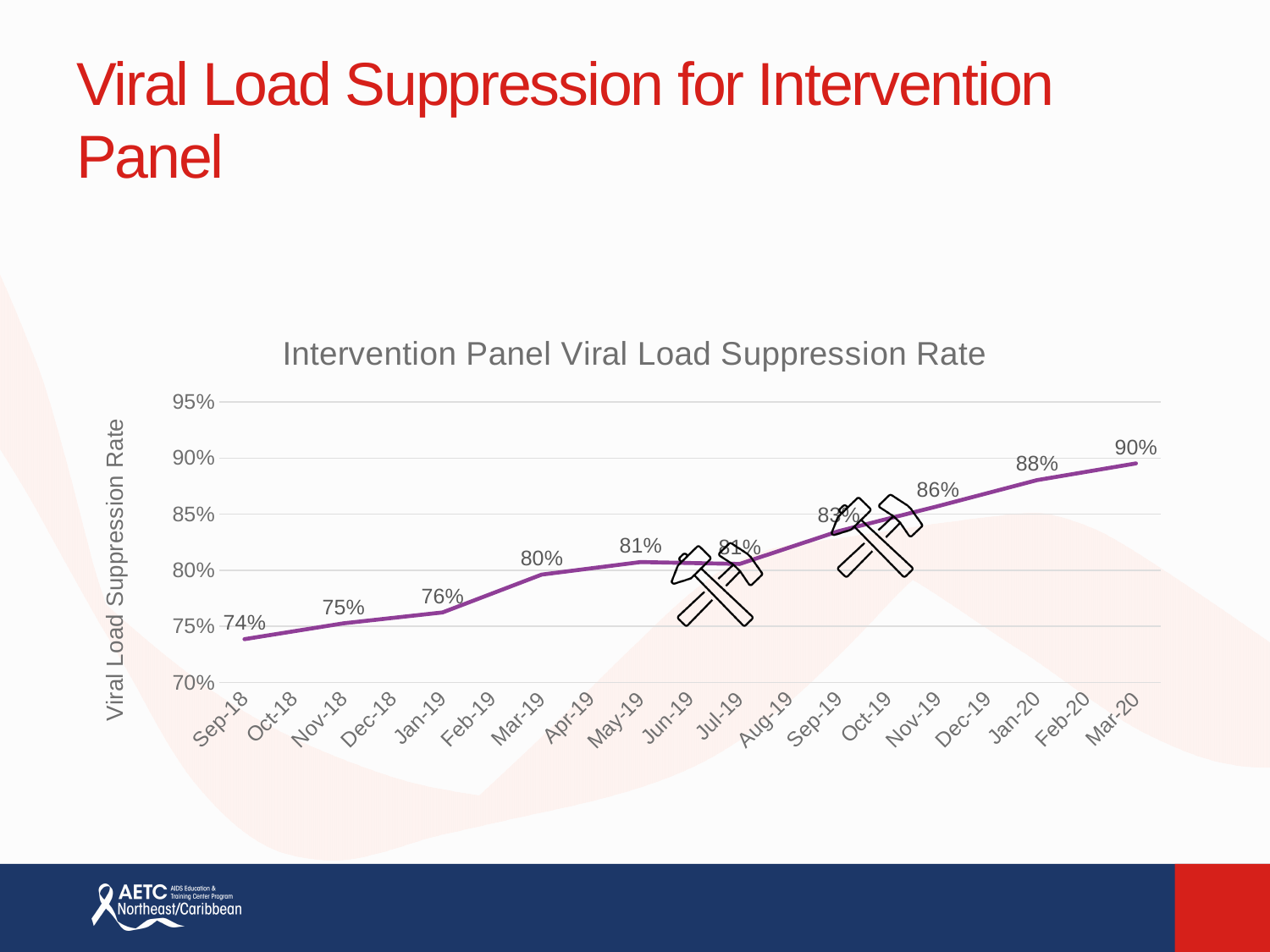
Does the viral load suppression rate rise or fall from Sep-18 to Mar-20? rise What is the viral load suppression rate for Mar-20? 90% Which month has the highest viral load suppression rate? Mar-20 Which month has the lowest viral load suppression rate? Sep-18 What type of chart is shown on the slide? line chart What is the viral load suppression rate for Mar-19? 80% What is the difference between the viral load suppression rate in Mar-20 and in Sep-18? 16% What is the title of the chart? Intervention Panel Viral Load Suppression Rate Which is larger, the rate for Jan-20 or the rate for Jan-19? Jan-20 What is the viral load suppression rate for Nov-19? 86% What is the viral load suppression rate for Sep-18? 74%